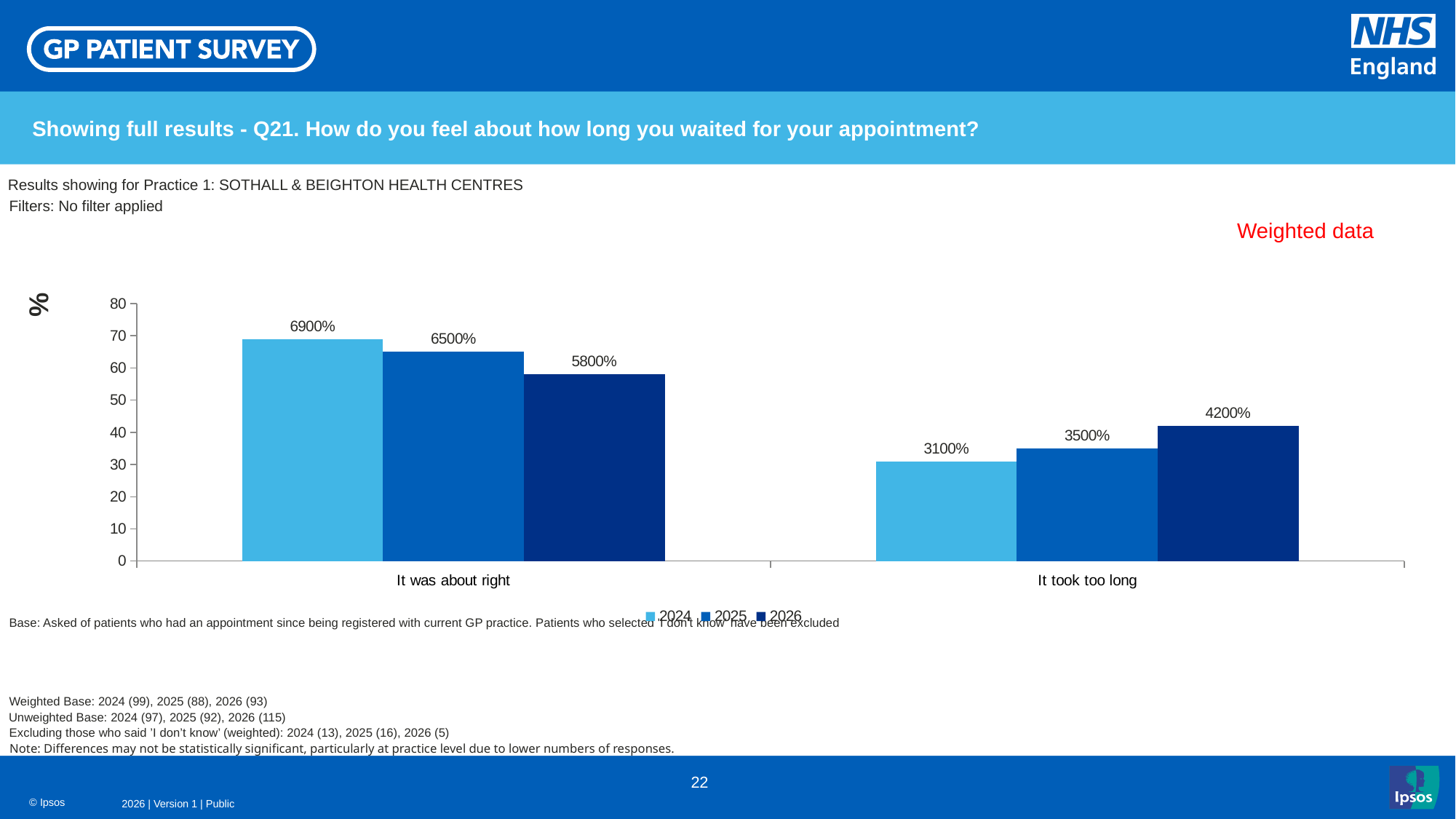
Which year has the highest value in the 'It was about right' category? 2024 How many series does the legend list? 3 What is the value for 2024 in the 'It was about right' category? 6900% Which is larger: the 2026 value for 'It was about right' or the 2026 value for 'It took too long'? It was about right What is the value for 2025 in the 'It was about right' category? 6500% Do the values for 'It took too long' rise or fall from 2024 to 2026? Rise What kind of chart is shown on the slide? Bar chart Which year has the lowest value in the 'It took too long' category? 2024 What is the value for 2026 in the 'It took too long' category? 4200% How many categories are shown on the x axis? 2 What is the value for 2024 in the 'It took too long' category? 3100% What are the entries listed in the chart legend? 2024, 2025, 2026